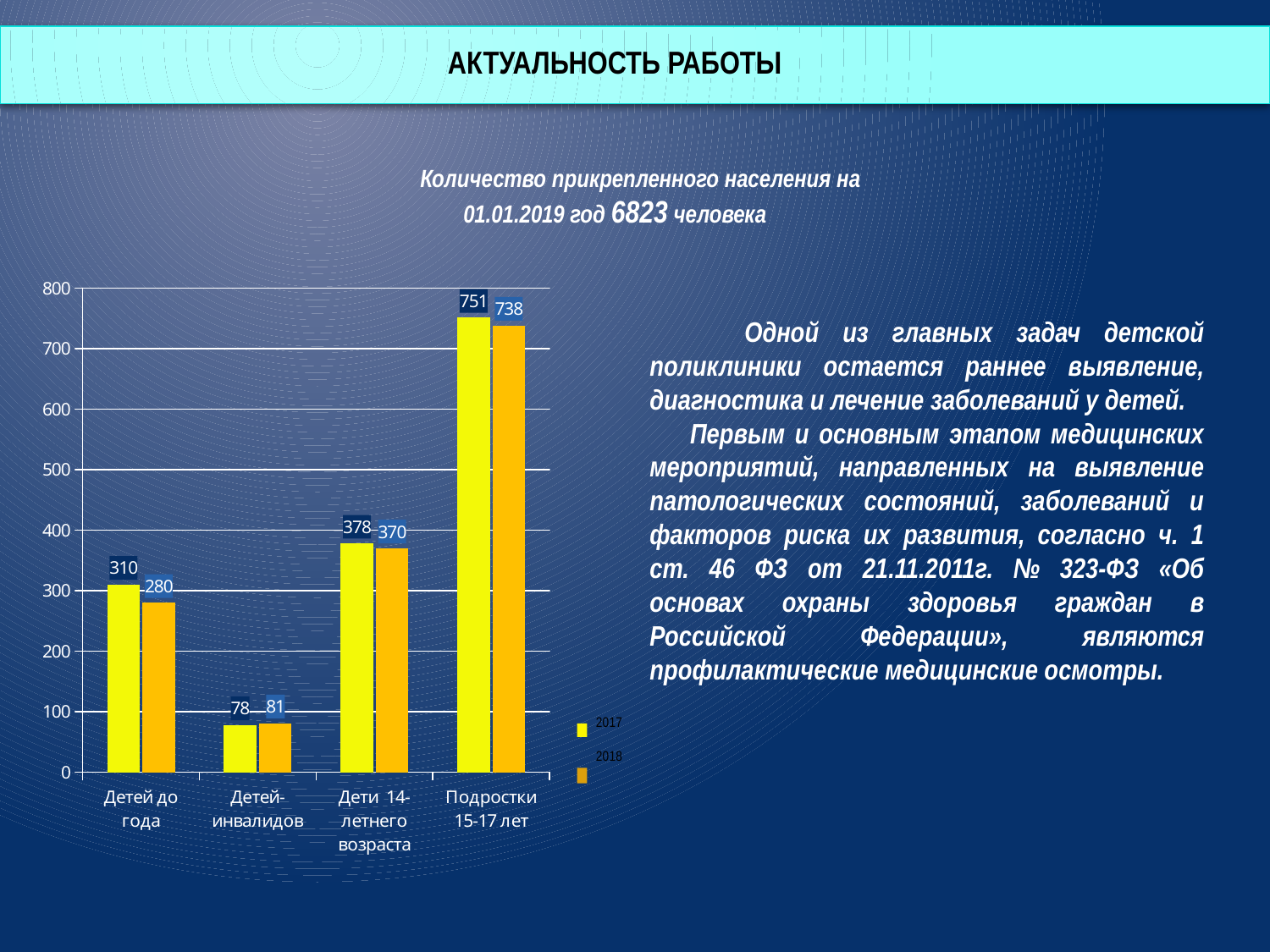
What is the 2017 value for Детей до года? 310 Which is larger for Дети 14-летнего возраста: the 2017 value or the 2018 value? 2017 What is the 2018 value for Подростки 15-17 лет? 738 How many categories are shown on the x axis? 4 What is the 2018 value for Детей-инвалидов? 81 Which category has the lowest 2018 value? Детей-инвалидов What is the difference between the 2017 and 2018 values for Детей до года? 30 Is the 2017 value for Подростки 15-17 лет greater or less than 700? greater Which category has the highest 2017 value? Подростки 15-17 лет Which series is shown in yellow in the legend? 2017 What kind of chart is shown on the slide? bar chart How many series does the legend list? 2